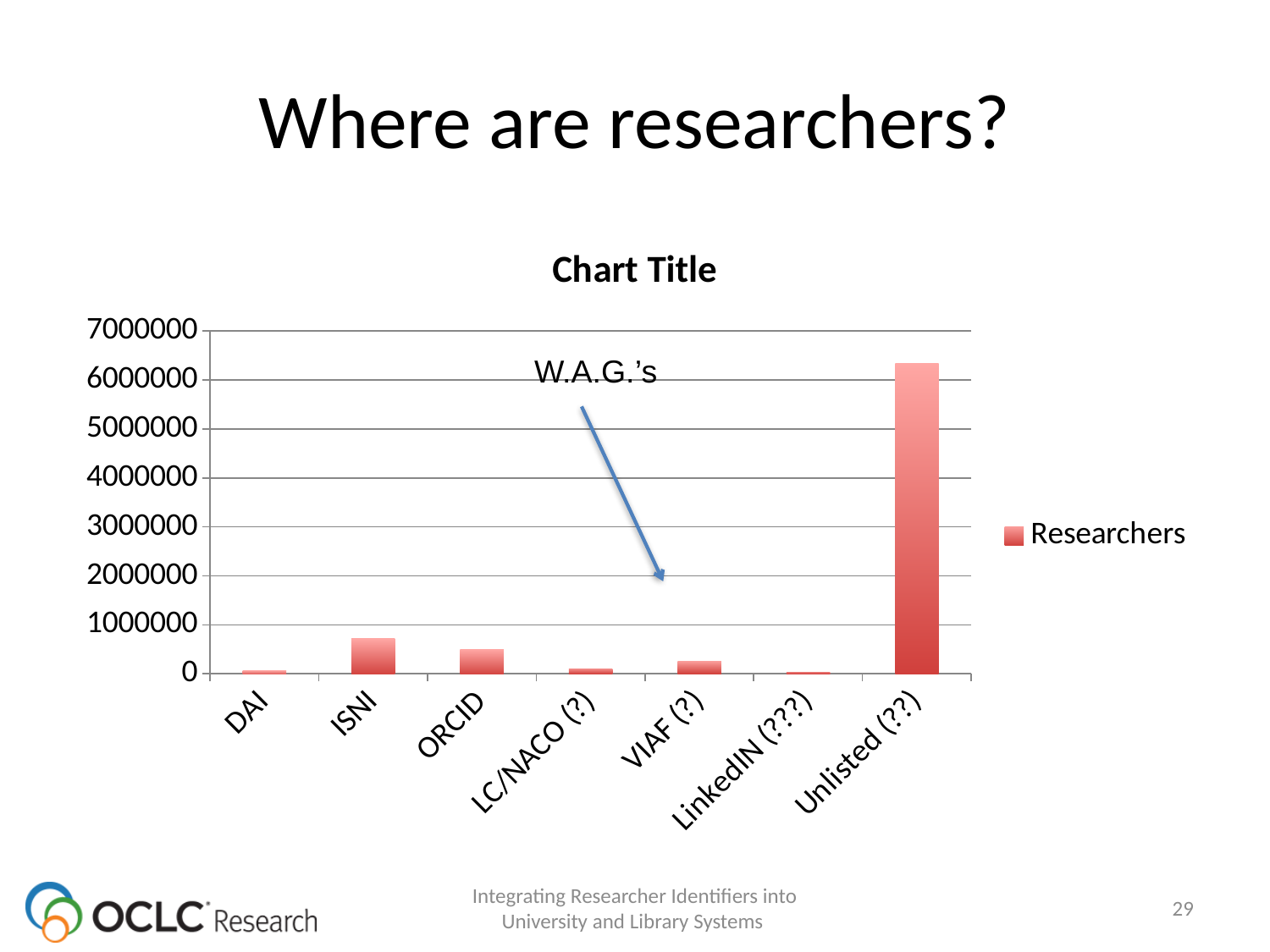
What is the name of the series listed in the chart's legend? Researchers Is the value for ORCID greater or less than 1000000? less Is the value for ISNI greater or less than 1000000? less How many categories are shown on the x axis of the chart? 7 What kind of chart is shown on the slide? bar chart Which category has the highest value in the chart? Unlisted (??) Is the value for VIAF (?) greater or less than 1000000? less Which has a larger value, Unlisted (??) or ISNI? Unlisted (??) Which has a larger value, ISNI or ORCID? ISNI How many series does the chart's legend list? 1 What is the title shown above the chart? Chart Title